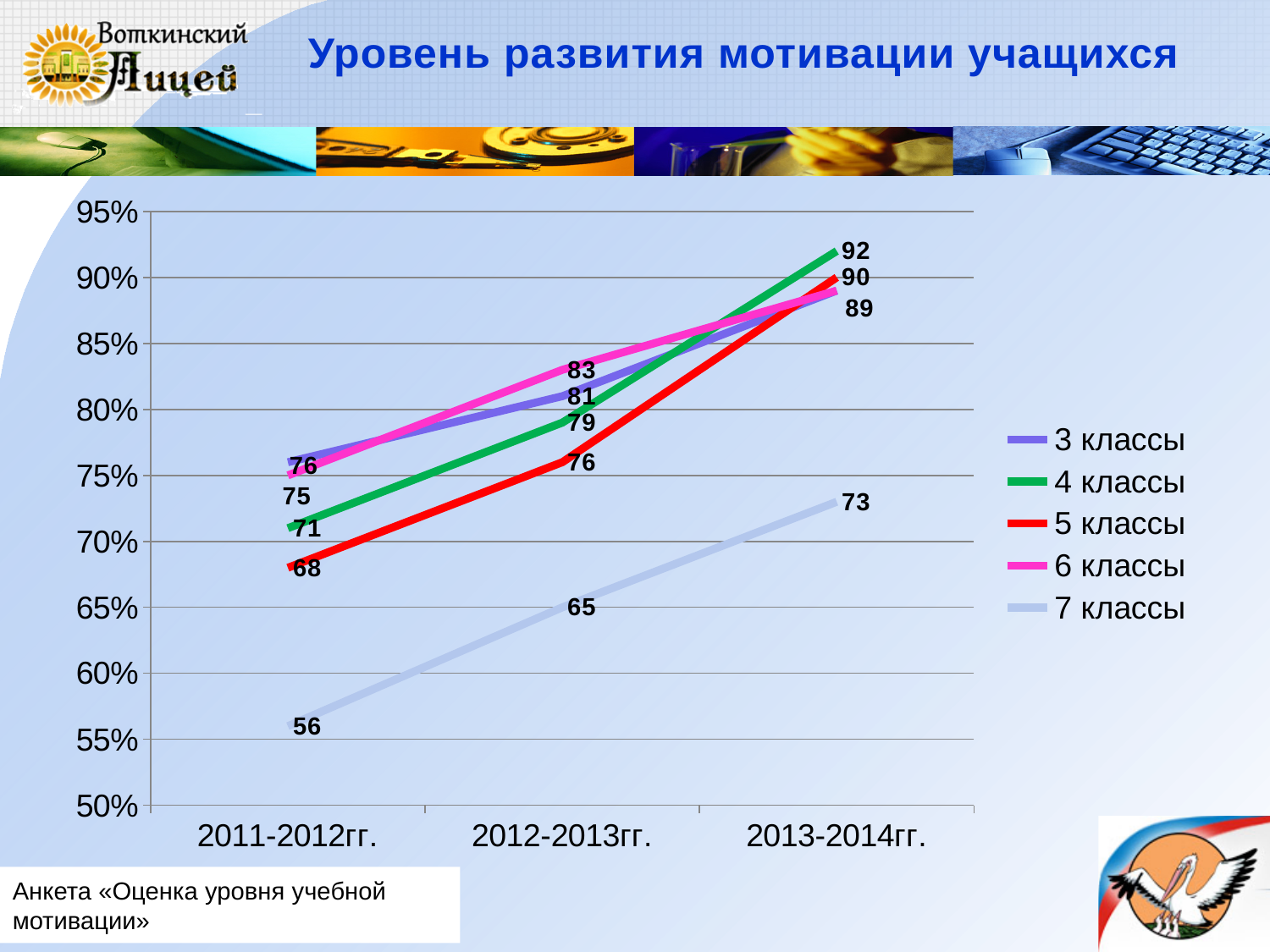
How many school-year categories are shown on the x axis? 3 Which series has the lowest value in 2012-2013гг.? 7 классы Which series has the highest value in 2013-2014гг.? 4 классы What is the value for 6 классы in 2012-2013гг.? 83 What is the value for 7 классы in 2011-2012гг.? 56 What kind of chart is shown on the slide? line chart What is the value for 4 классы in 2013-2014гг.? 92 Do the values for 5 классы rise or fall from 2011-2012гг. to 2013-2014гг.? rise What is the value for 5 классы in 2011-2012гг.? 68 How many series does the legend list? 5 In 2012-2013гг., which is larger: the value for 6 классы or for 3 классы? 6 классы By how much did the value for 7 классы increase from 2011-2012гг. to 2013-2014гг.? 17